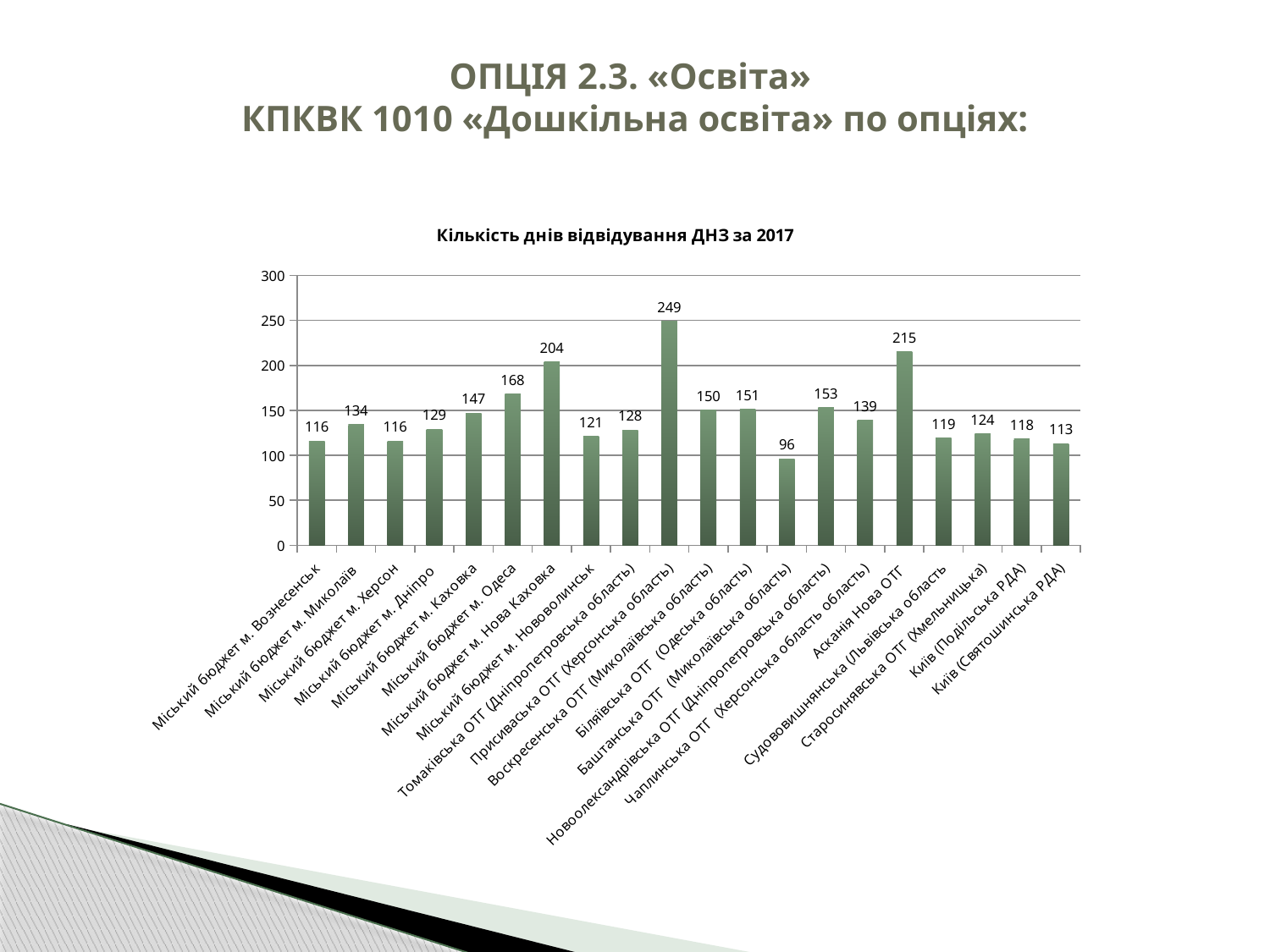
Which is larger, the value for Міський бюджет м. Миколаїв or the value for Чаплинська ОТГ (Херсонська область)? Чаплинська ОТГ (Херсонська область) What is the value for Баштанська ОТГ (Миколаївська область)? 96 Which category has the highest value? Присиваська ОТГ (Херсонська область) What is the difference between the values for Міський бюджет м. Нова Каховка and Міський бюджет м. Каховка? 57 How many categories are shown on the chart? 20 Is the value for Новоолександрівська ОТГ (Дніпропетровська область) greater or less than 100? greater Which category has the lowest value? Баштанська ОТГ (Миколаївська область) What is the value for Асканія Нова ОТГ? 215 What is the title of the chart? Кількість днів відвідування ДНЗ за 2017 What is the value for Міський бюджет м. Одеса? 168 What kind of chart is shown on the slide? bar chart What is the value for Київ (Святошинська РДА)? 113